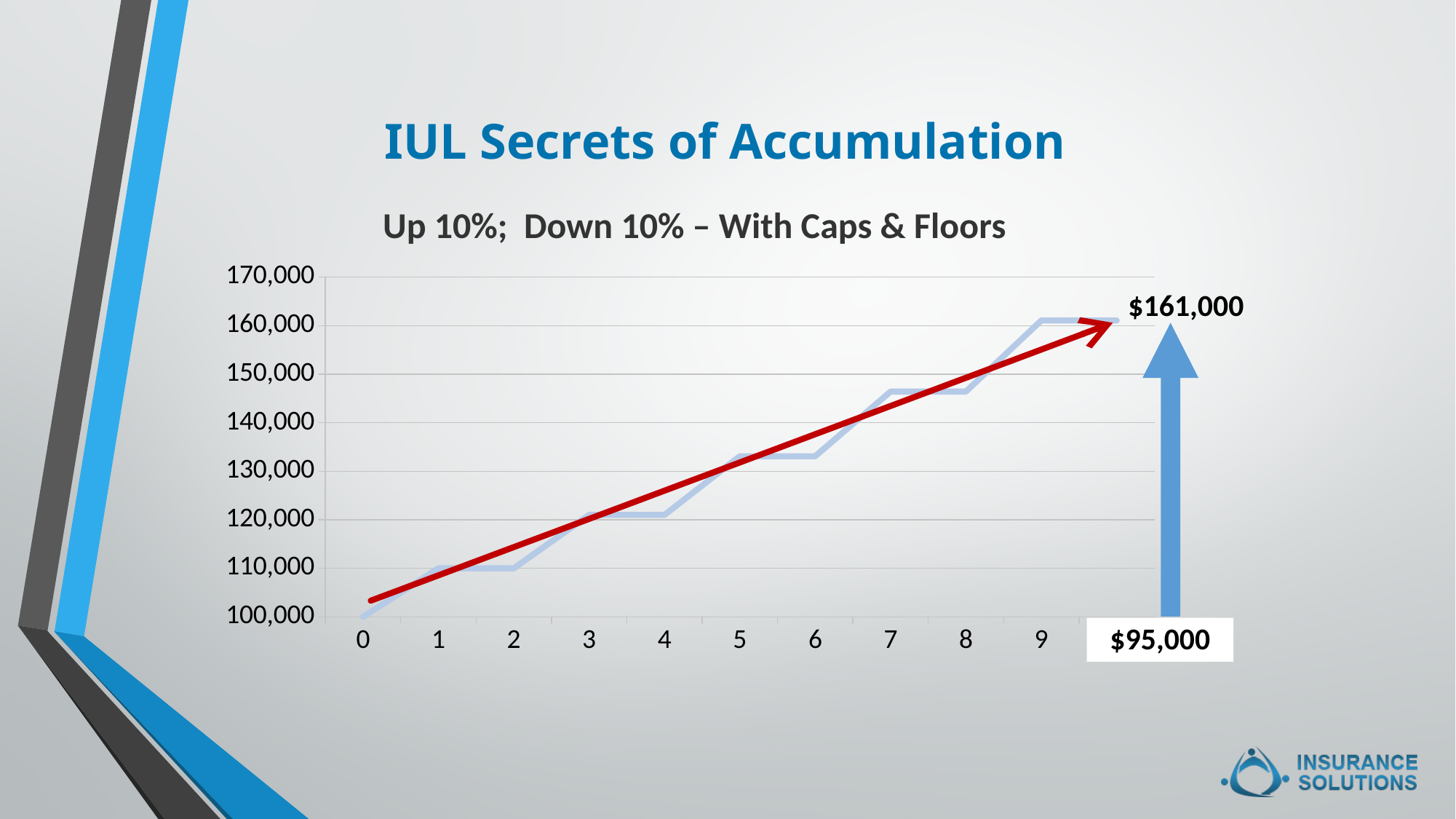
What is the value of the line at x = 0? 100,000 Do the values generally rise or fall as x increases from 0 to 9? rise What value is labelled at the end of the line in the chart? $161,000 What is the title of the chart? Up 10%; Down 10% – With Caps & Floors What is the difference between the labelled end value of $161,000 and the starting value of 100,000? 61,000 Is the value at x = 4 greater or less than 130,000? less Which is larger, the value at x = 3 or the value at x = 7? x = 7 What is the value of the line at x = 1? 110,000 Is the value at x = 8 greater or less than 150,000? less Is the value at x = 7 greater or less than 140,000? greater What kind of chart is shown on the slide? line chart